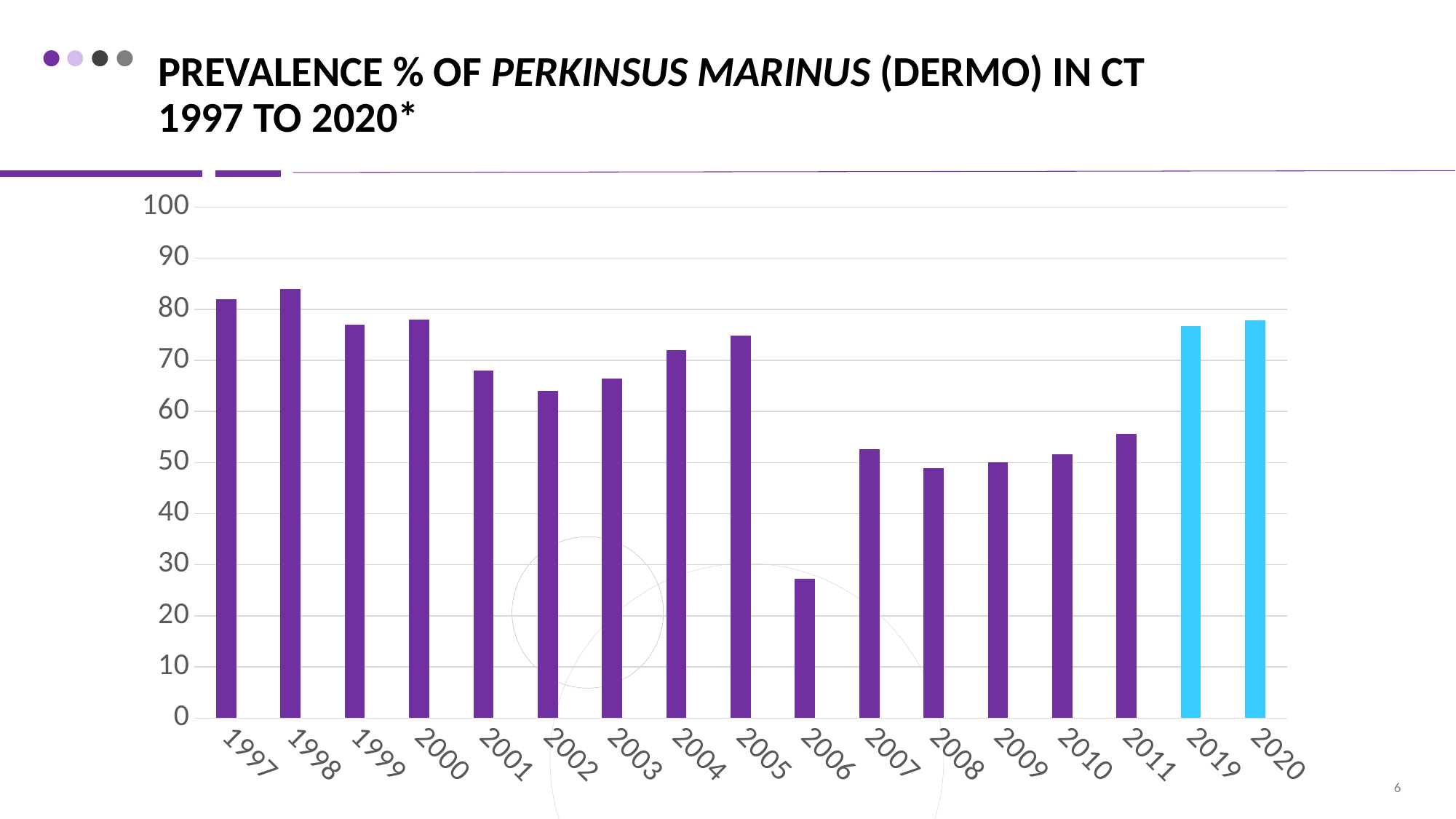
Do the values rise or fall from 2002 to 2005? rise Which year has the lowest prevalence in the chart? 2006 Is the value for 1997 greater or less than 80? greater What kind of chart is shown on the slide? Bar chart Is the value for 2001 greater or less than 70? less Which year has the larger value, 2004 or 2005? 2005 Which year has the larger value, 1997 or 2011? 1997 What colour are the bars for 2019 and 2020? Blue Which year has the highest prevalence in the chart? 1998 How many years (bars) are plotted in the chart? 17 Is the value for 2002 greater or less than 60? greater